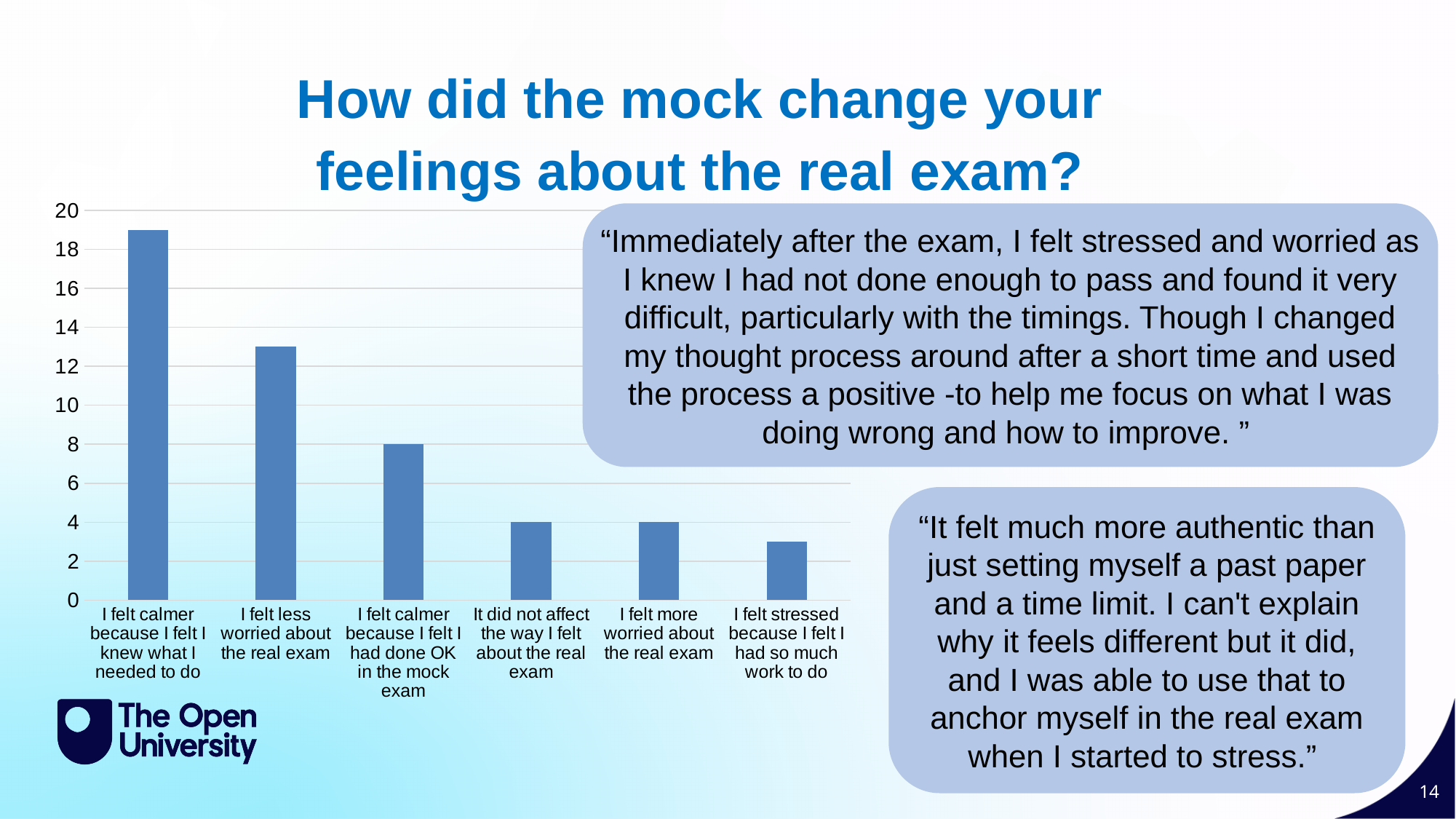
Is the value for 'I felt stressed because I felt I had so much work to do' greater or less than 4? less What is the value for 'It did not affect the way I felt about the real exam'? 4 How many categories are shown on the x axis of the chart? 6 Which category has the highest bar? I felt calmer because I felt I knew what I needed to do Is the value for 'I felt calmer because I felt I knew what I needed to do' greater or less than 18? greater Do the bar values generally rise or fall from left to right along the x axis? fall What kind of chart is shown on the slide? bar chart Which is larger: the value for 'I felt calmer because I felt I knew what I needed to do' or the value for 'I felt less worried about the real exam'? I felt calmer because I felt I knew what I needed to do What is the value for 'I felt calmer because I felt I had done OK in the mock exam'? 8 What is the difference between the value for 'I felt calmer because I felt I had done OK in the mock exam' and the value for 'I felt more worried about the real exam'? 4 Which category has the lowest bar? I felt stressed because I felt I had so much work to do Is the value for 'I felt less worried about the real exam' greater or less than 14? less